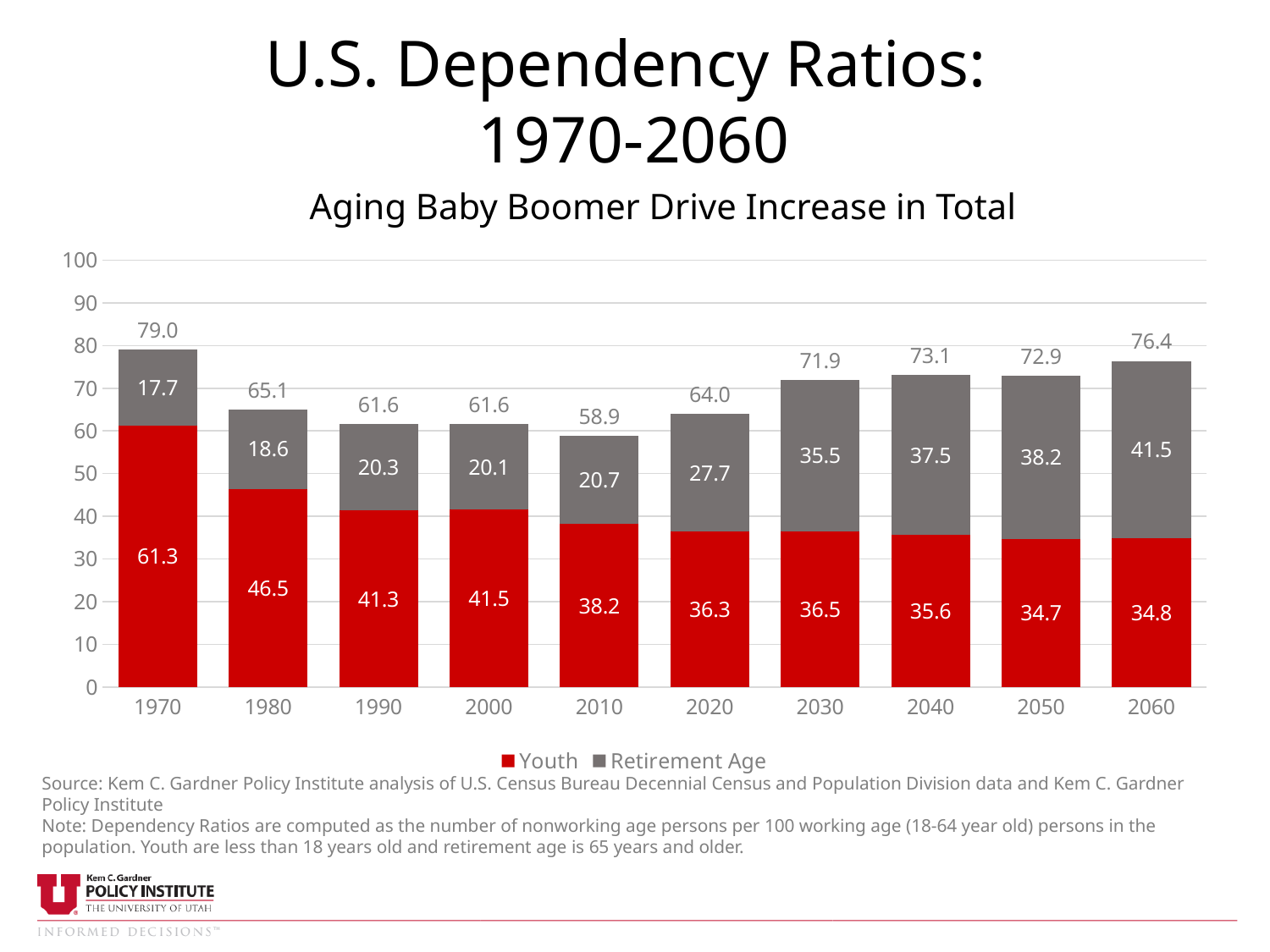
How many years are shown on the x axis? 10 What is the Youth dependency ratio for 1970? 61.3 How many series does the legend list? 2 Which colour represents the Youth series? Red Which is larger, the Youth value for 1980 or the Youth value for 2020? 1980 Which year has the highest total dependency ratio? 1970 What is the total dependency ratio shown above the bar for 2010? 58.9 What is the Retirement Age dependency ratio for 2060? 41.5 Which year has the lowest Youth dependency ratio? 2050 What kind of chart is shown on the slide? Stacked bar chart Does the Retirement Age value rise or fall from 2020 to 2060? Rise What is the difference between the Retirement Age values for 2060 and 1970? 23.8